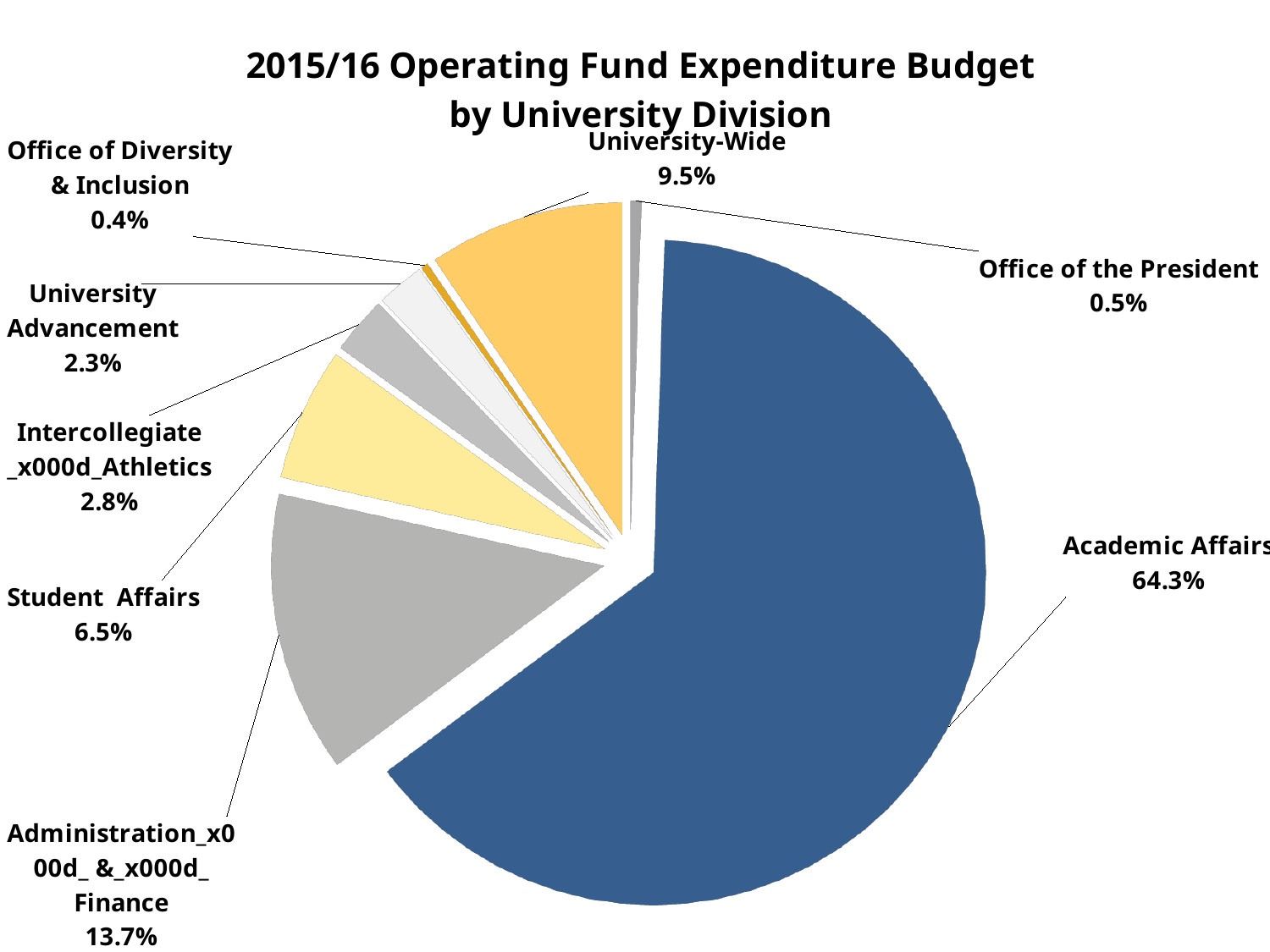
Which division has the smallest share of the expenditure budget? Office of Diversity & Inclusion What is the title of the chart? 2015/16 Operating Fund Expenditure Budget by University Division Which has a larger share, Student Affairs or University-Wide? University-Wide How many divisions are shown in the pie chart? 8 Which has a larger share, Intercollegiate Athletics or University Advancement? Intercollegiate Athletics What type of chart is shown on the slide? Pie chart What percentage of the budget is allocated to Administration & Finance? 13.7% Which division has the largest share of the expenditure budget? Academic Affairs What is the difference in percentage points between Academic Affairs and Administration & Finance? 50.6 What percentage does Student Affairs receive? 6.5% What is the share for University-Wide? 9.5% What share of the 2015/16 Operating Fund Expenditure Budget goes to Academic Affairs? 64.3%